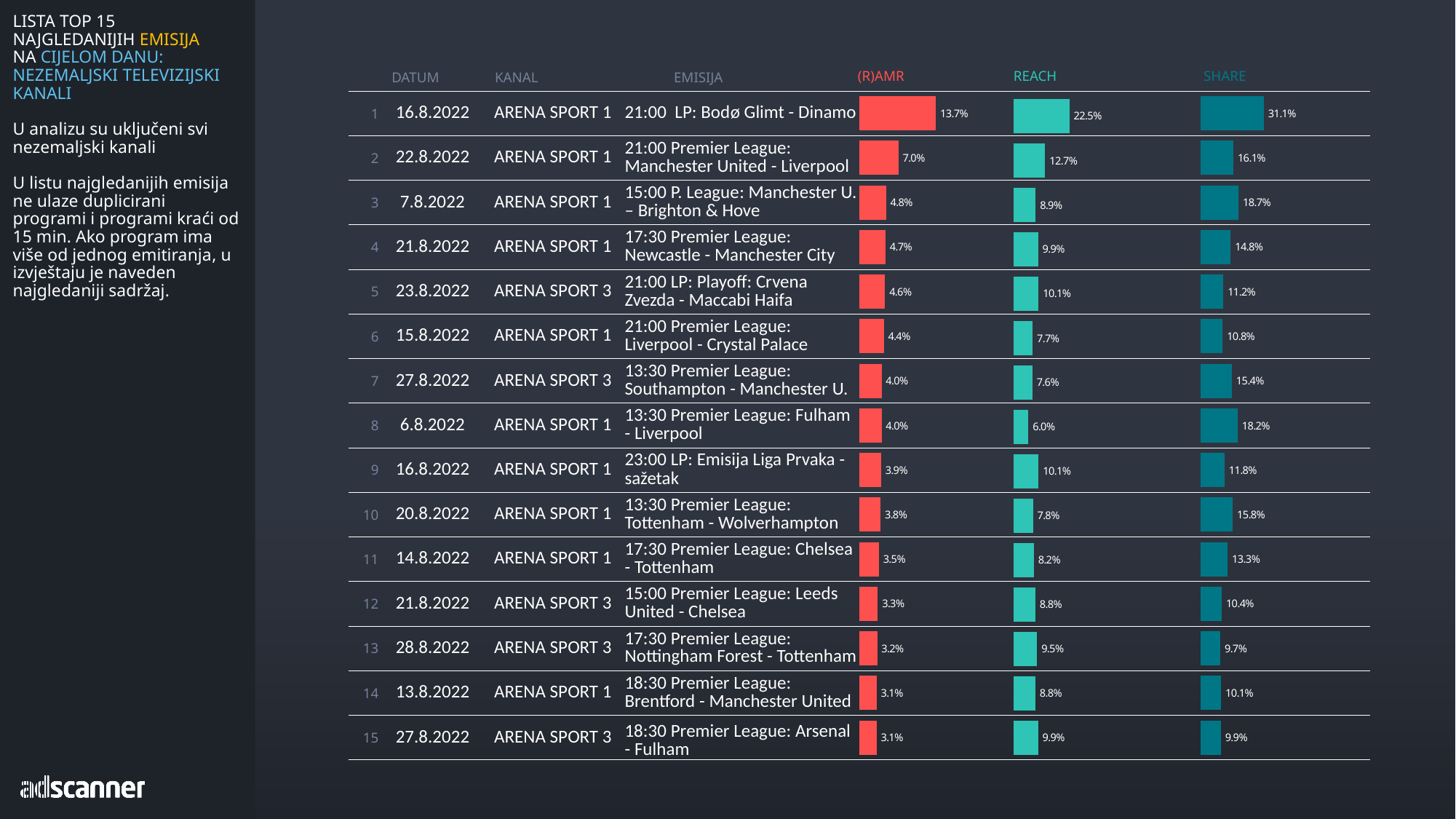
What colour are the bars in the (R)AMR column? Red Do the (R)AMR values rise or fall going down the list from rank 1 to rank 15? Fall How many programmes are listed in the table? 15 Which programme has the lowest REACH value? 13:30 Premier League: Fulham - Liverpool What kind of chart is used to display the (R)AMR, REACH and SHARE values? Bar chart What is the REACH value for '17:30 Premier League: Nottingham Forest - Tottenham'? 9.5% What is the SHARE value for '13:30 Premier League: Fulham - Liverpool'? 18.2% Which has a higher SHARE value: '15:00 P. League: Manchester U. – Brighton & Hove' or '17:30 Premier League: Newcastle - Manchester City'? 15:00 P. League: Manchester U. – Brighton & Hove Which programme has the highest SHARE value? 21:00 LP: Bodø Glimt - Dinamo What is the difference in (R)AMR between '21:00 LP: Bodø Glimt - Dinamo' and '21:00 Premier League: Manchester United - Liverpool'? 6.7% What is the (R)AMR value for the programme '21:00 LP: Bodø Glimt - Dinamo'? 13.7% What is the REACH value for '21:00 Premier League: Manchester United - Liverpool'? 12.7%